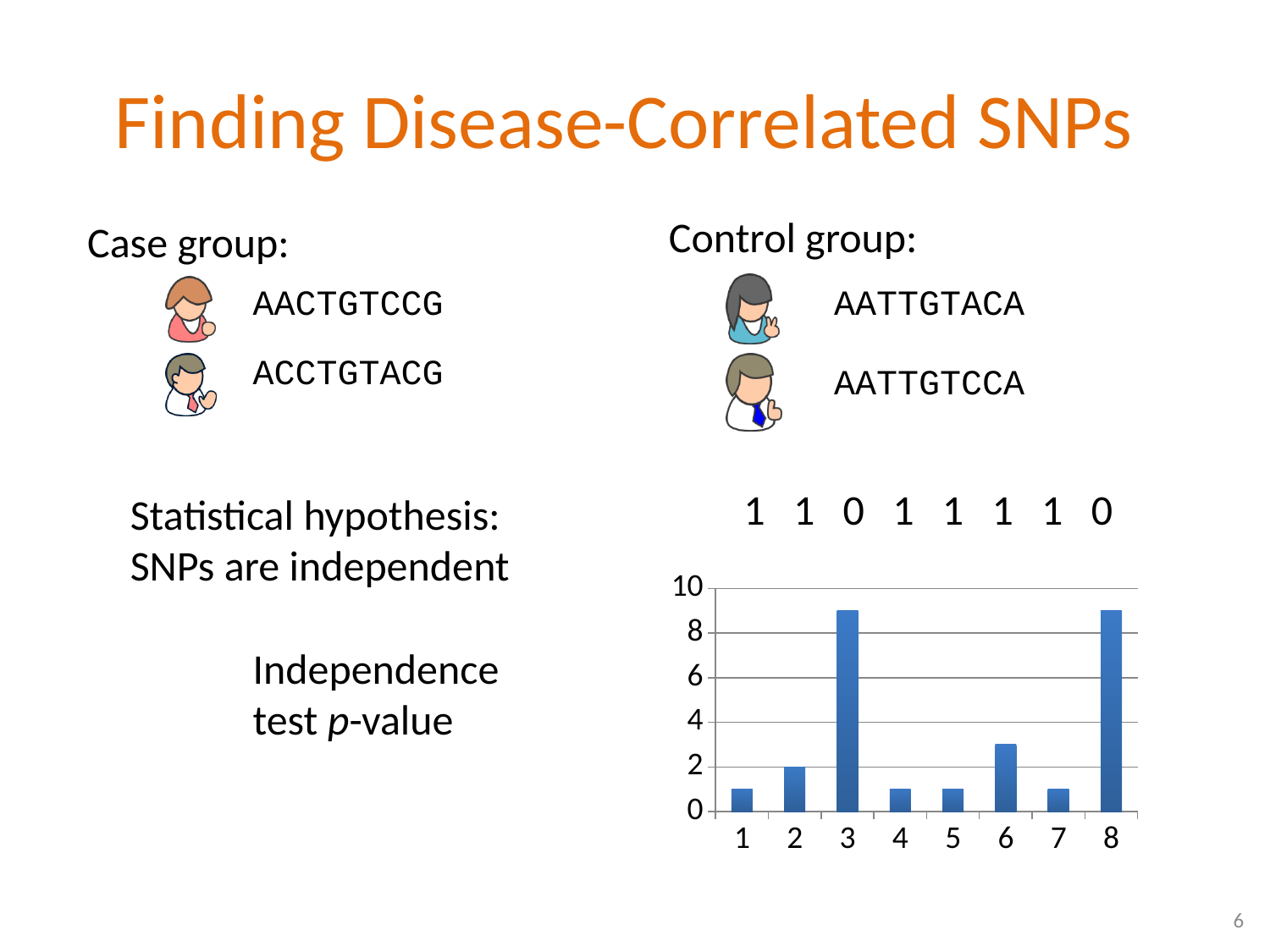
Is the value for category 6 greater or less than 4? less How many categories are shown on the x axis of the bar chart? 8 What is the value for category 2 in the bar chart? 2 Which has the larger value in the bar chart, category 6 or category 2? category 6 What is the highest value labelled on the y axis of the bar chart? 10 Is the value for category 6 greater or less than 2? greater Which has the larger value in the bar chart, category 3 or category 6? category 3 Is the value for category 7 greater or less than 2? less What kind of chart is shown on the slide? bar chart